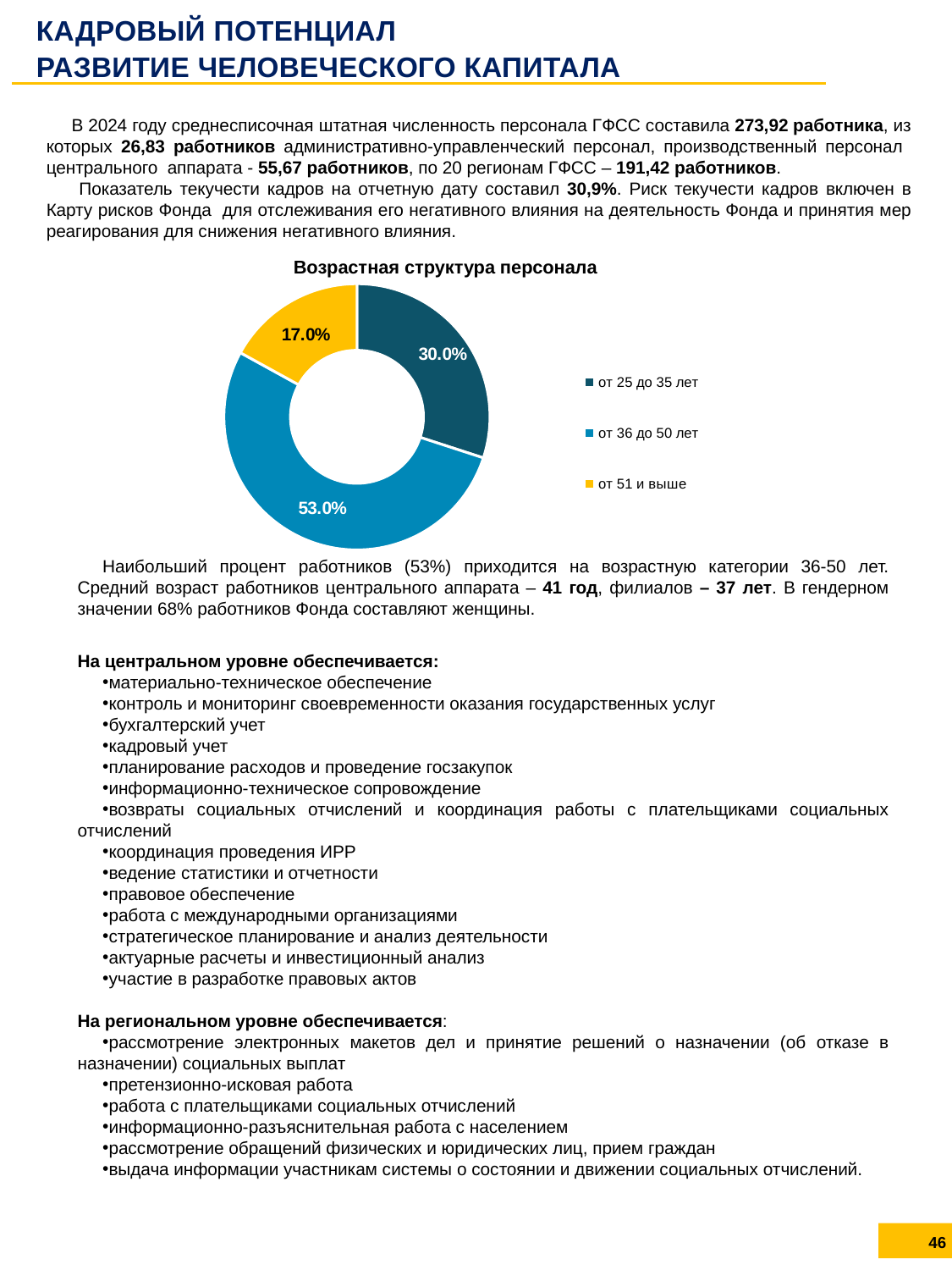
What is the difference in percentage points between the 'от 36 до 50 лет' and 'от 25 до 35 лет' groups? 23.0 percentage points What is the title of the chart on the slide? Возрастная структура персонала What is the difference in percentage points between the 'от 25 до 35 лет' and 'от 51 и выше' groups? 13.0 percentage points Which age group has the smallest share of staff? от 51 и выше Which group has a larger share: 'от 25 до 35 лет' or 'от 51 и выше'? от 25 до 35 лет What share of staff is in the age group 'от 51 и выше'? 17.0% Which age group has the largest share of staff? от 36 до 50 лет Which colour represents the 'от 51 и выше' group in the chart? Yellow What share of staff is in the age group 'от 25 до 35 лет'? 30.0% How many age categories does the chart show? 3 What share of staff is in the age group 'от 36 до 50 лет'? 53.0% What type of chart is shown on the slide? Doughnut (pie) chart